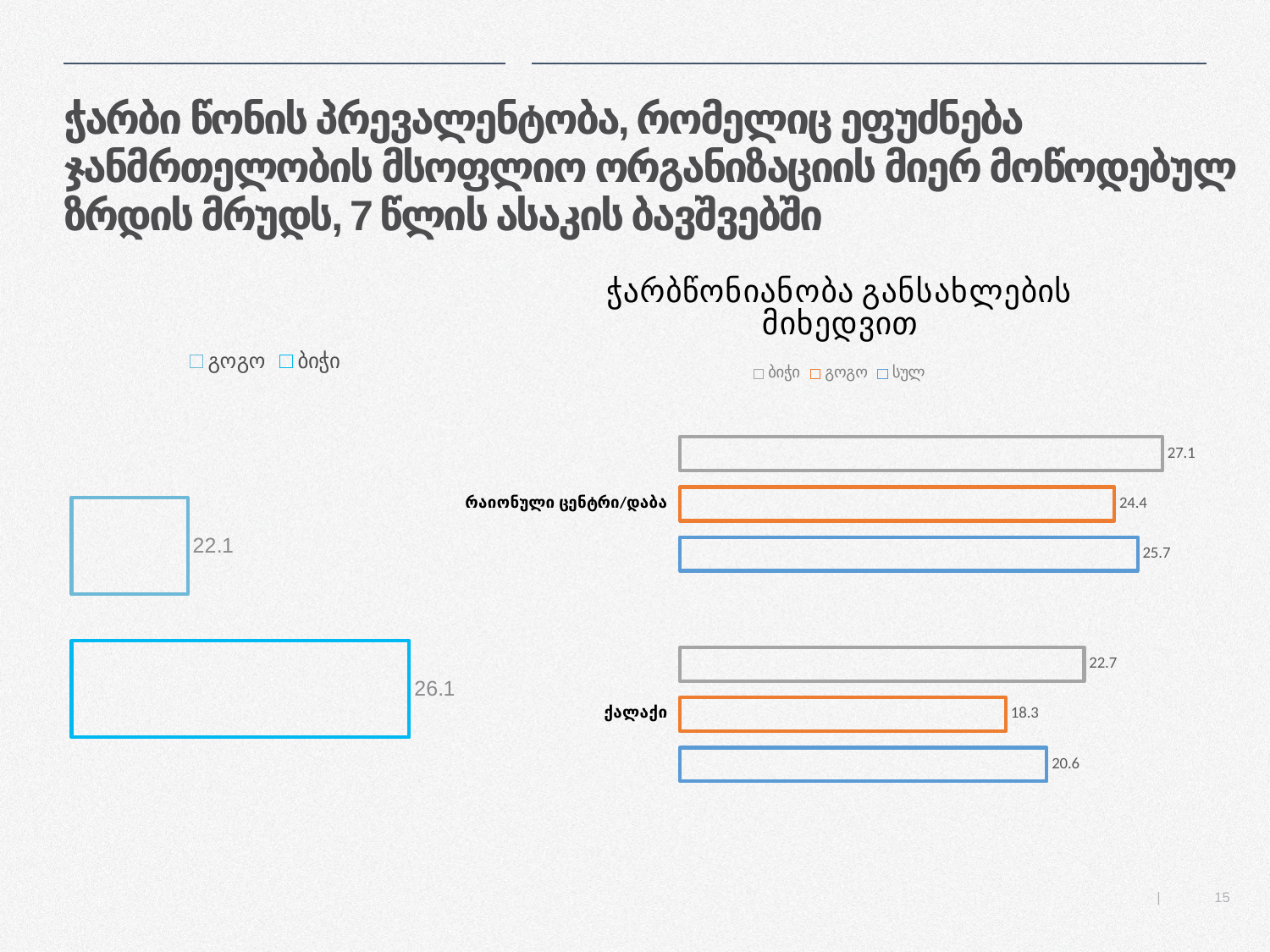
What type of chart is the chart titled ჭარბწონიანობა განსახლების მიხედვით? bar chart On the chart titled ჭარბწონიანობა განსახლების მიხედვით, which series has the lowest value in ქალაქი? გოგო On the chart titled ჭარბწონიანობა განსახლების მიხედვით, what is the value for ბიჭი in რაიონული ცენტრი/დაბა? 27.1 On the chart titled ჭარბწონიანობა განსახლების მიხედვით, how many series does the legend list? 3 On the left chart, what is the difference between the two bar values? 4.0 On the left chart, what value is printed on the top bar? 22.1 On the left chart, what value is printed on the bottom bar? 26.1 On the left chart, how many series does the legend list? 2 On the chart titled ჭარბწონიანობა განსახლების მიხედვით, what is the value for სულ in ქალაქი? 20.6 On the chart titled ჭარბწონიანობა განსახლების მიხედვით, which is larger: გოგო in რაიონული ცენტრი/დაბა or გოგო in ქალაქი? რაიონული ცენტრი/დაბა On the chart titled ჭარბწონიანობა განსახლების მიხედვით, what is the difference between სულ in რაიონული ცენტრი/დაბა and სულ in ქალაქი? 5.1 On the chart titled ჭარბწონიანობა განსახლების მიხედვით, what is the value for გოგო in ქალაქი? 18.3